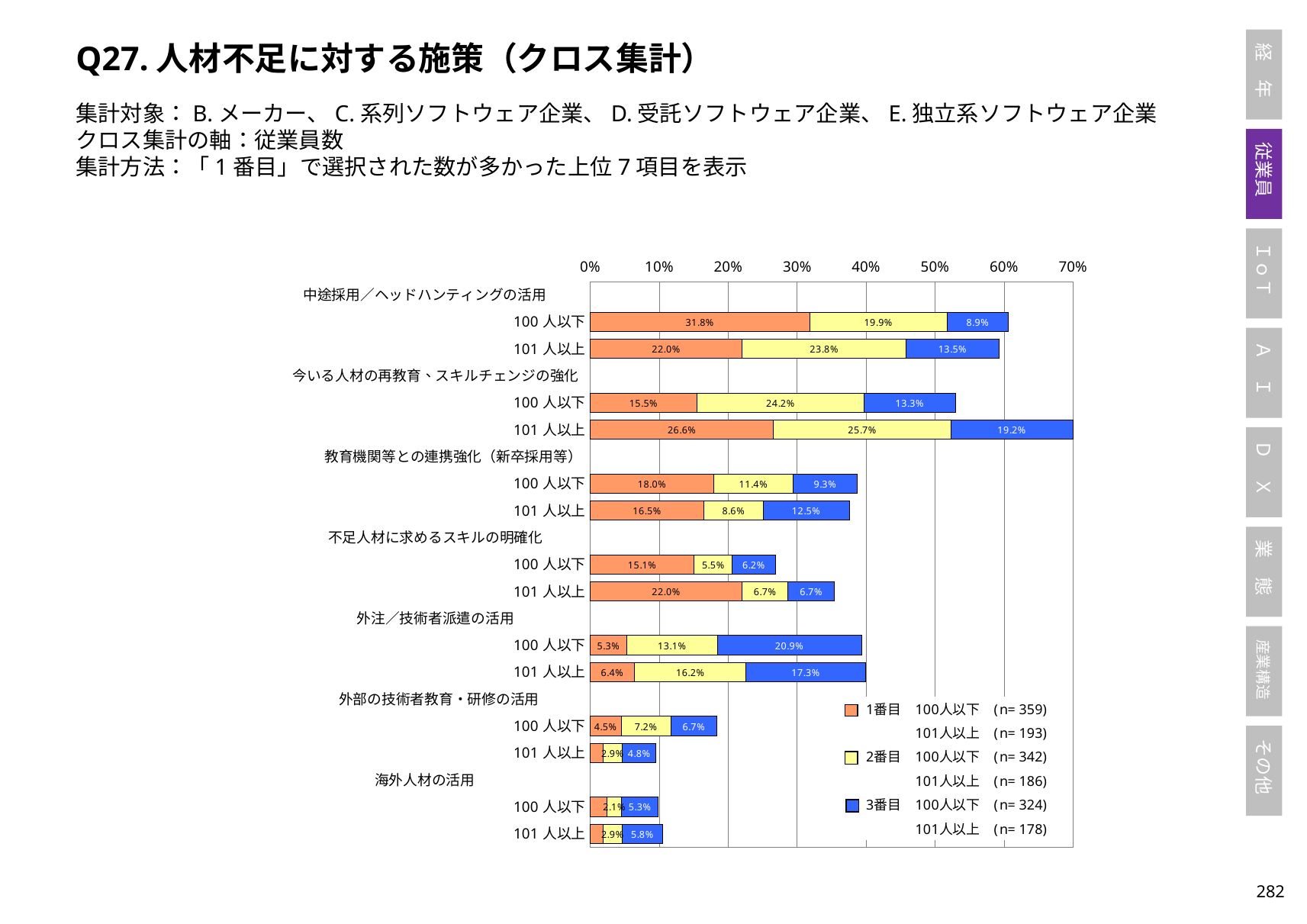
According to the legend, what is the n for 1番目, 100人以下? 359 What is the 3番目 value for 今いる人材の再教育、スキルチェンジの強化, 101人以上? 19.2% What is the total of the stacked bar for 中途採用／ヘッドハンティングの活用, 100人以下? 60.6% What is the difference between the 1番目 values for 中途採用／ヘッドハンティングの活用 100人以下 and 101人以上? 9.8 percentage points What kind of chart is shown on the slide? bar chart Which bar has the highest 1番目 value? 中途採用／ヘッドハンティングの活用, 100人以下 (31.8%) Is the total length of the stacked bar for 今いる人材の再教育、スキルチェンジの強化, 101人以上 greater or less than 60%? greater How many series does the legend list? 3 How many 施策 (measure) categories are shown in the chart? 7 What is the 1番目 value for 中途採用／ヘッドハンティングの活用, 100人以下? 31.8% What is the 2番目 value for 外注／技術者派遣の活用, 101人以上? 16.2% For 外注／技術者派遣の活用, which has the larger 3番目 value, 100人以下 or 101人以上? 100人以下